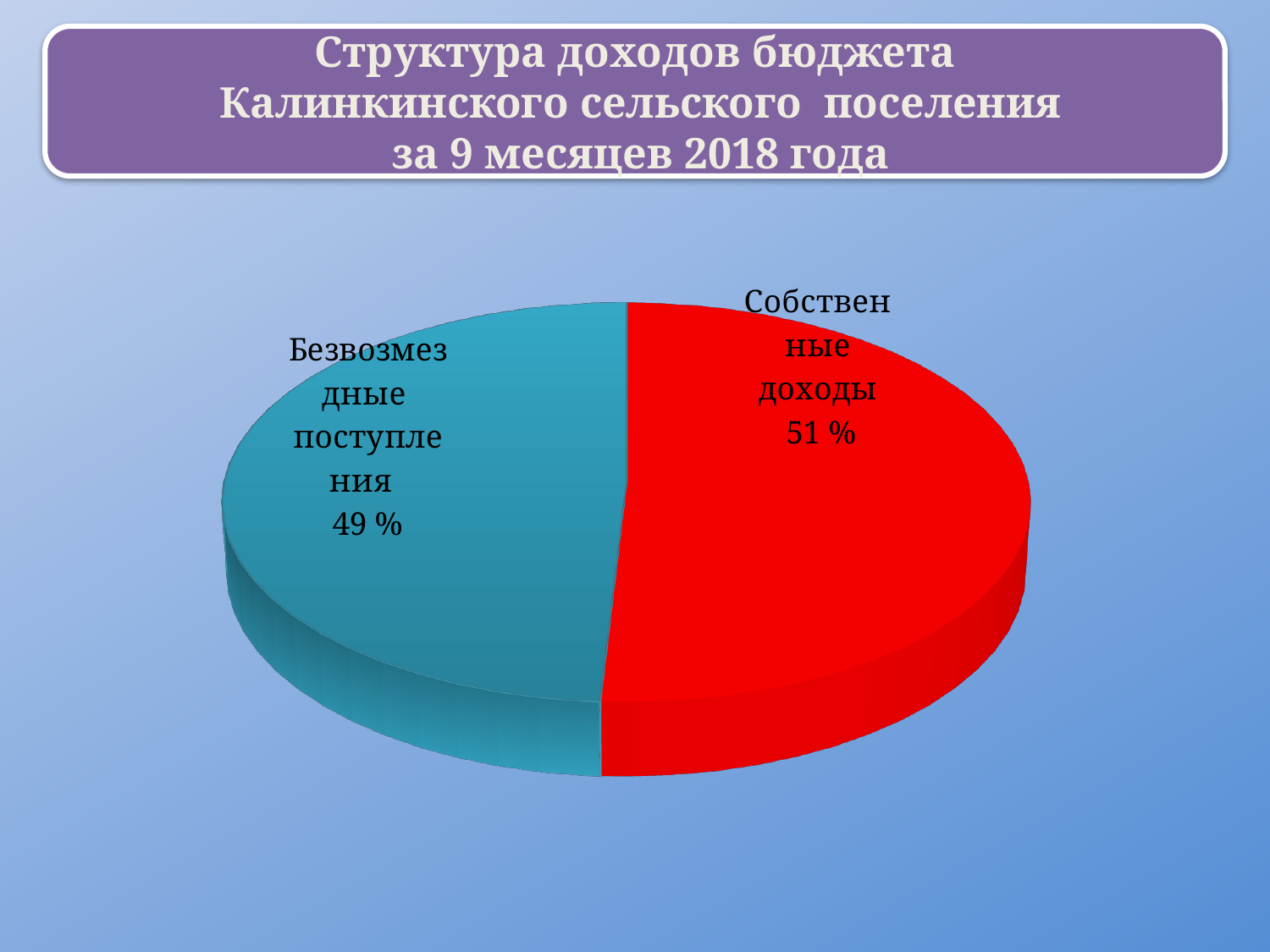
What kind of chart is shown on the slide? Pie chart Which slice of the pie is the smallest? Безвозмездные поступления What is the title of the slide containing the chart? Структура доходов бюджета Калинкинского сельского поселения за 9 месяцев 2018 года What is the value shown for "Безвозмездные поступления"? 49 % Which slice of the pie is the largest? Собственные доходы Which is larger: "Собственные доходы" or "Безвозмездные поступления"? Собственные доходы What share of the pie does "Безвозмездные поступления" have? 49 % What share of the pie does "Собственные доходы" have? 51 % What colour is the slice for "Собственные доходы"? Red How many slices does the pie chart have? 2 What is the value shown for "Собственные доходы"? 51 % What is the difference in percentage points between "Собственные доходы" and "Безвозмездные поступления"? 2 %